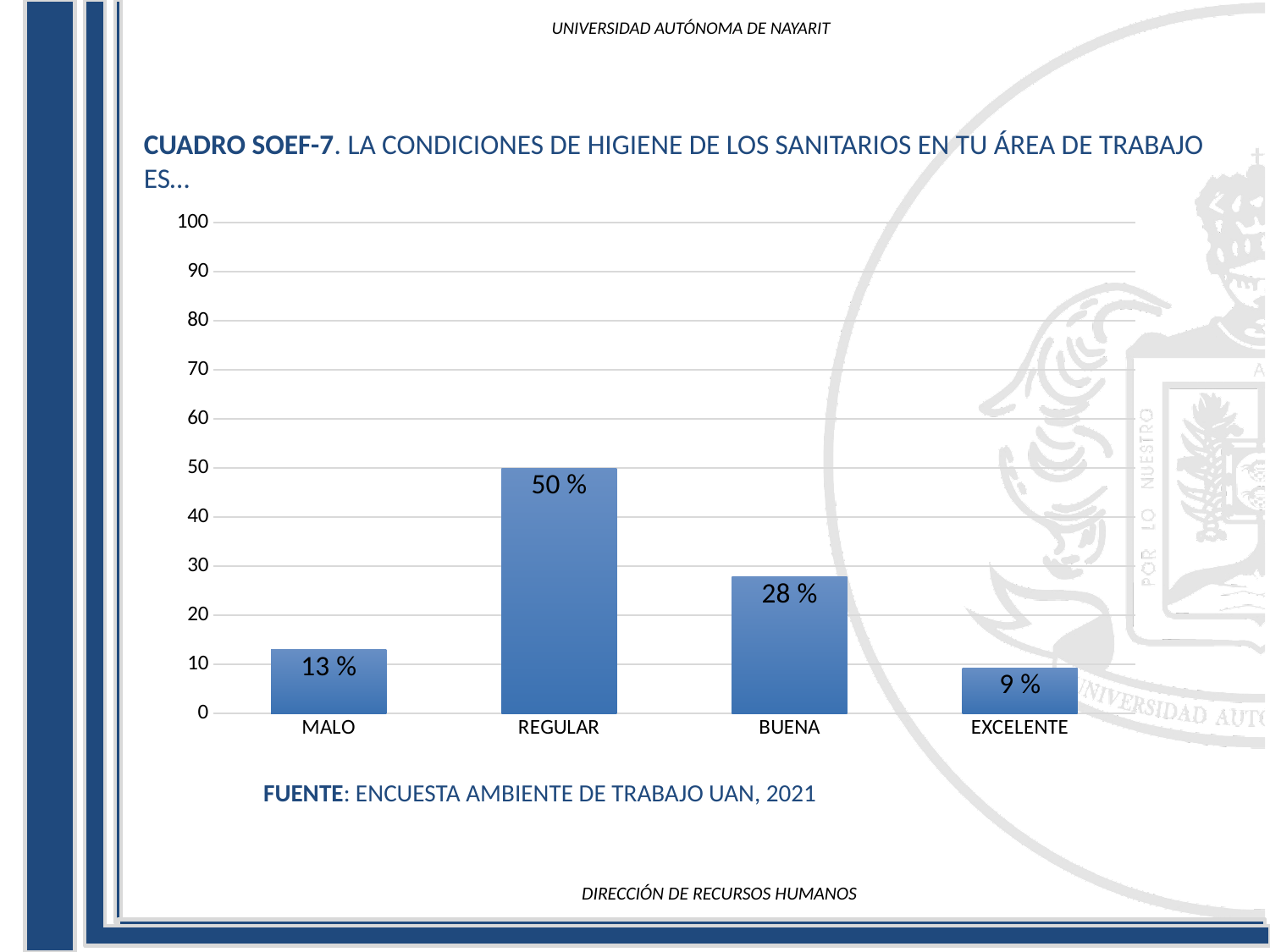
What is the value for EXCELENTE? 9 % What is the difference between the values for MALO and EXCELENTE? 4 % What is the difference between the values for REGULAR and BUENA? 22 % What is the value for MALO? 13 % How many categories are shown on the x axis? 4 What kind of chart is shown on the slide? bar chart What is the value for REGULAR? 50 % What is the source cited below the chart? ENCUESTA AMBIENTE DE TRABAJO UAN, 2021 Is the value for BUENA greater or less than 30? less Which category has the lowest value? EXCELENTE Which is larger, the value for MALO or the value for BUENA? BUENA Which category has the highest value? REGULAR